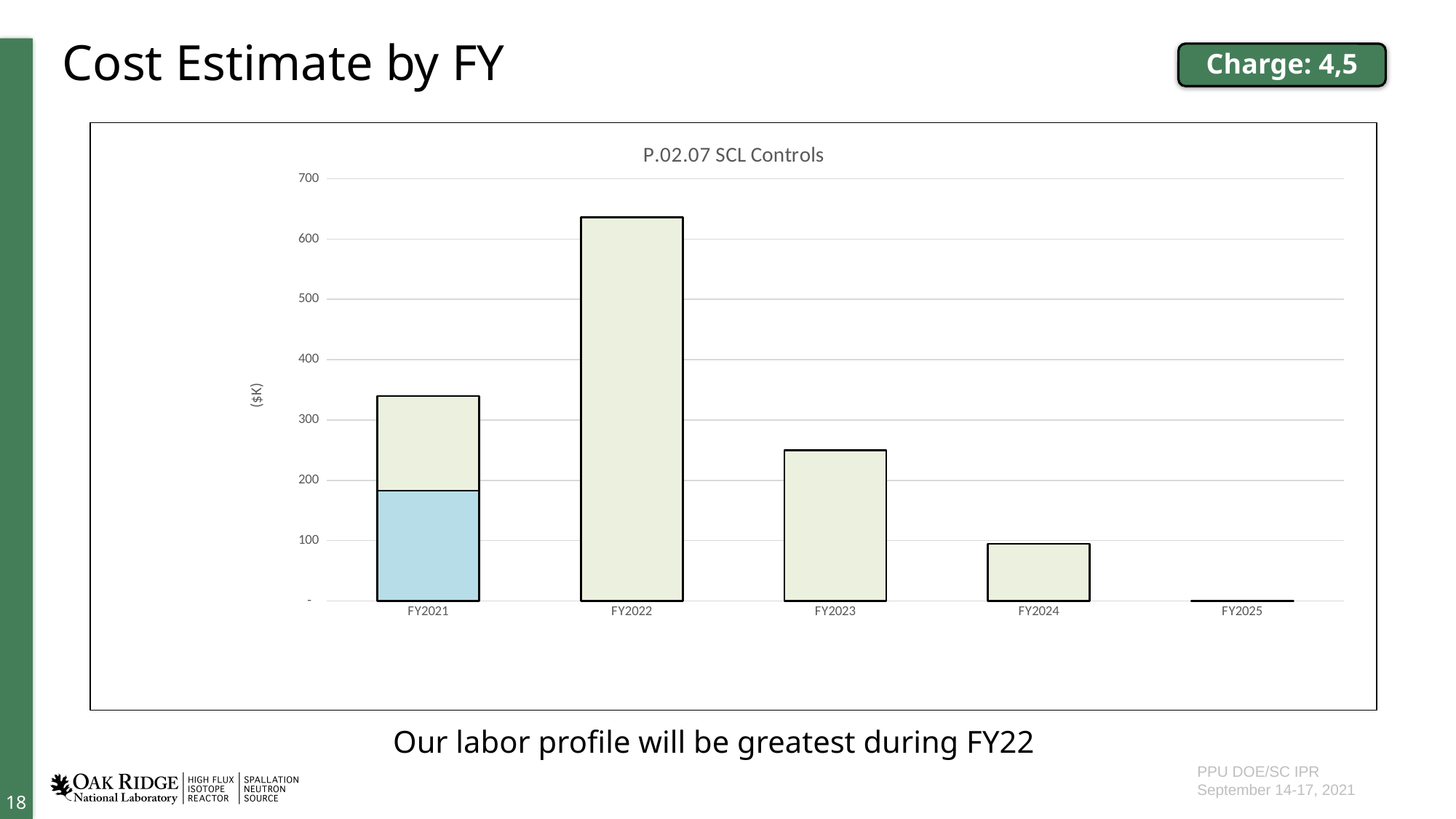
What kind of chart is shown on the slide? bar chart Which is larger, the total bar for FY2021 or the bar for FY2023? FY2021 How many fiscal year categories are shown on the x axis? 5 Which fiscal year has the highest total bar? FY2022 Which fiscal year has the lowest total bar? FY2025 Is the total value for FY2021 greater or less than 300? greater Is the value for FY2023 greater or less than 300? less Is the total value for FY2022 greater or less than 600? greater Do the bar values rise or fall from FY2022 to FY2025? fall What is the title of the chart? P.02.07 SCL Controls What is the label on the vertical axis of the chart? ($K)